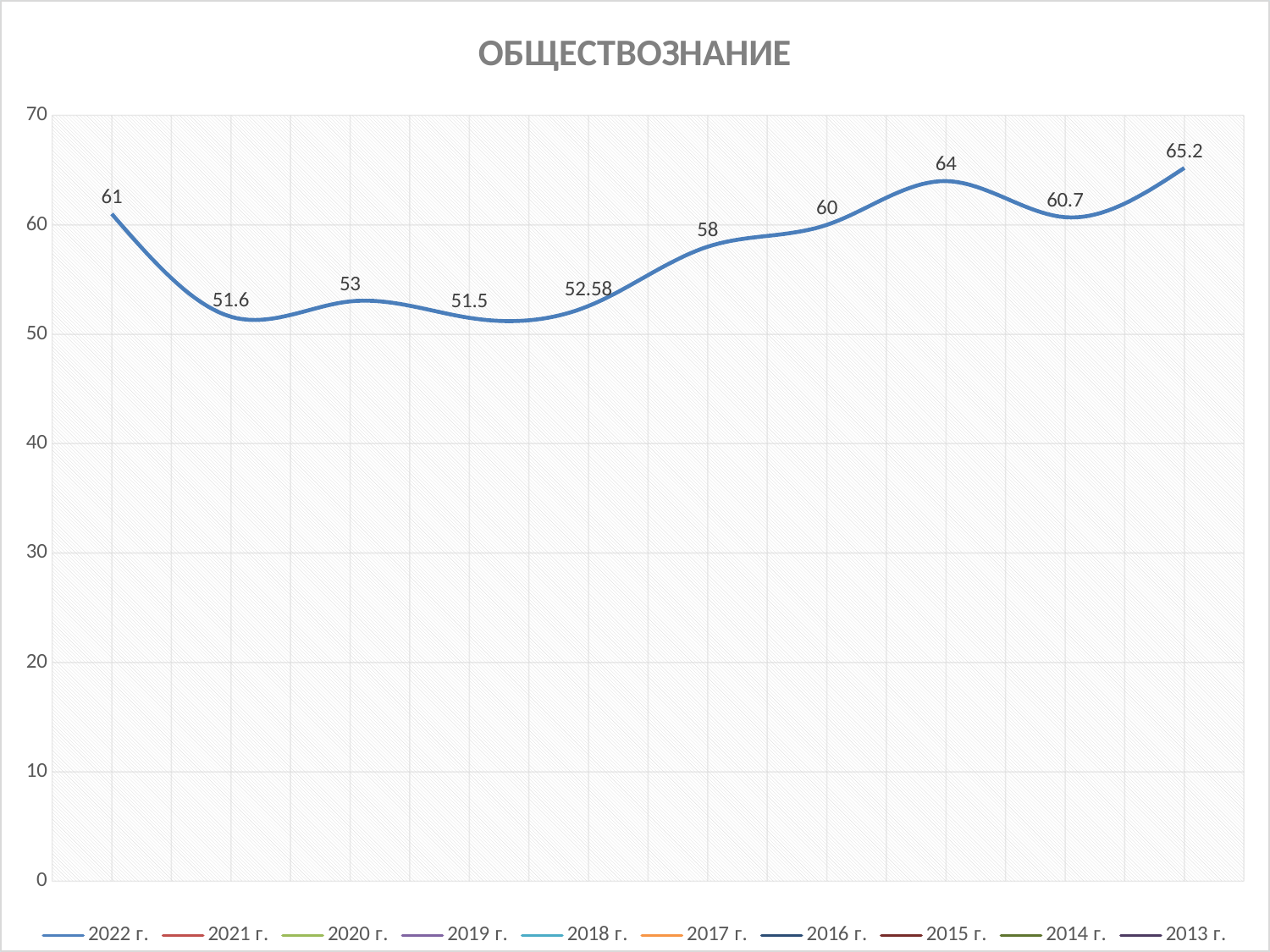
What is the value of the first (leftmost) point on the line? 61 What kind of chart is shown on the slide? line chart How many entries does the legend list? 10 What is the value of the fifth point from the left? 52.58 What is the value of the last (rightmost) point on the line? 65.2 What is the title of the chart? ОБЩЕСТВОЗНАНИЕ Which is larger, the point labelled 64 or the point labelled 60.7? 64 What is the difference between the last point (65.2) and the first point (61)? 4.2 What is the lowest value labelled on the line? 51.5 What is the highest value labelled on the line? 65.2 How many data points are plotted on the line? 10 Is the value of the second point from the left greater or less than 60? less